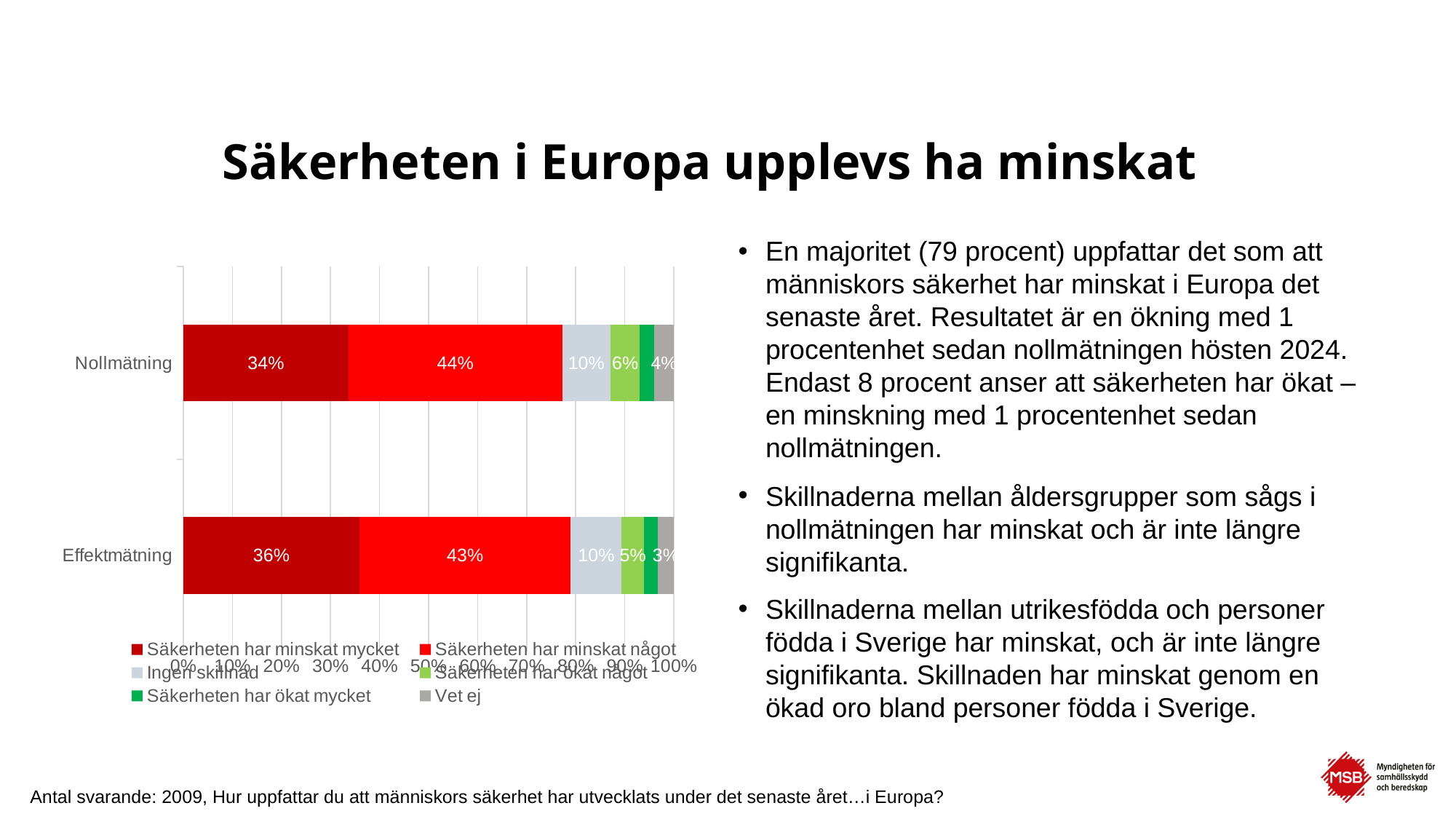
What is the value for 'Vet ej' in the Effektmätning bar? 3% Which bar has the larger value for 'Säkerheten har minskat något', Nollmätning or Effektmätning? Nollmätning What is the value for 'Säkerheten har minskat mycket' in the Nollmätning bar? 34% What is the value for 'Ingen skillnad' in the Effektmätning bar? 10% How many categories (bars) are shown in the chart? 2 What is the value for 'Säkerheten har ökat något' in the Nollmätning bar? 6% What is the difference between the 'Säkerheten har minskat mycket' values for Effektmätning and Nollmätning? 2 percentage points What is the value for 'Säkerheten har minskat något' in the Effektmätning bar? 43% How many series does the chart legend list? 6 Which colour represents 'Säkerheten har minskat mycket' in the chart? Dark red Which series has the largest segment in the Effektmätning bar? Säkerheten har minskat något What kind of chart is shown on the slide? Stacked bar chart